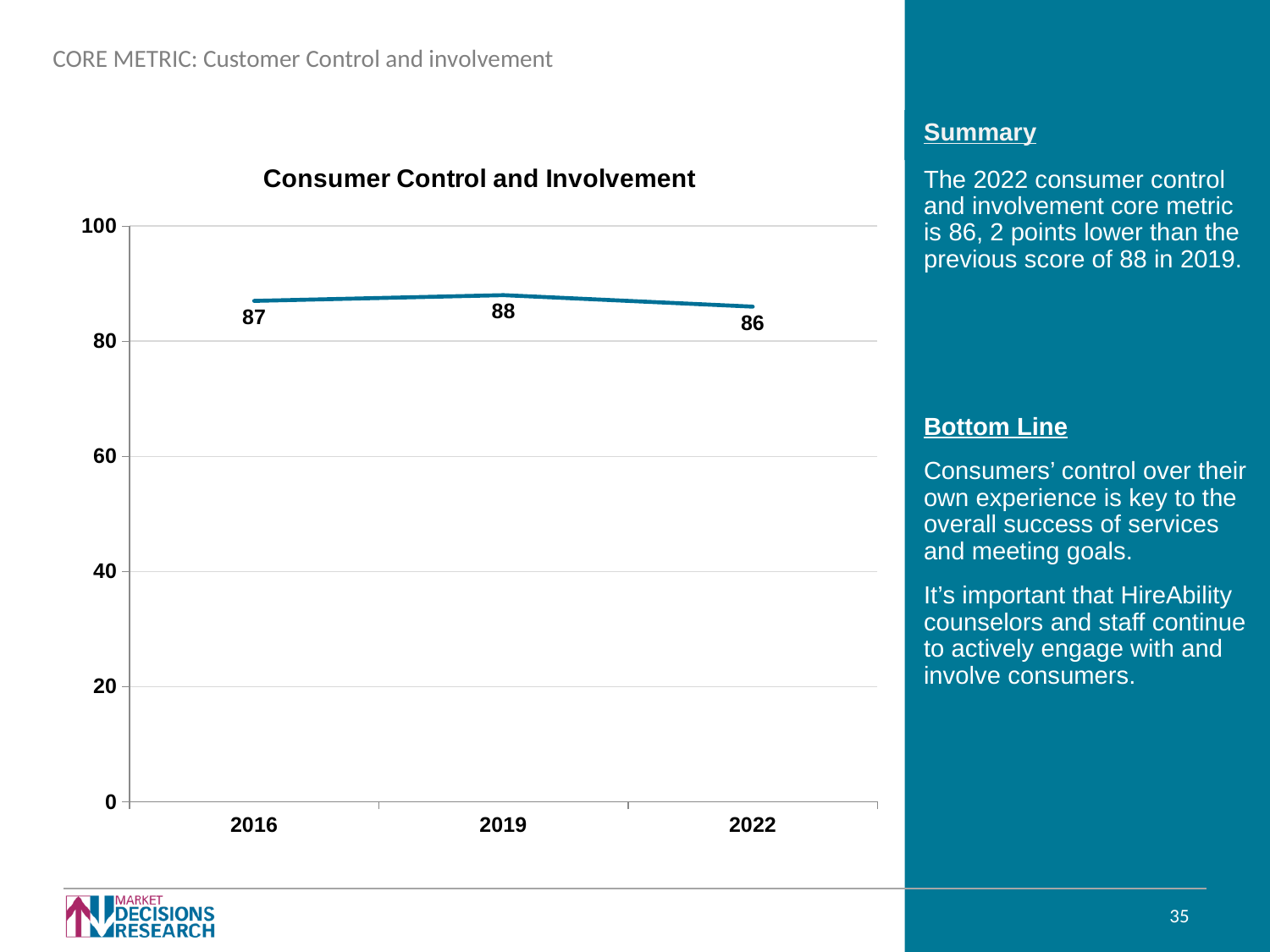
What is the difference between the values for 2019 and 2022? 2 Is the value for 2022 greater or less than 80? greater What kind of chart is shown? line chart Which is larger, the value for 2016 or the value for 2022? 2016 What is the value for 2022? 86 Which year has the lowest value? 2022 Which year has the highest value? 2019 What is the difference between the values for 2016 and 2019? 1 What is the title of the chart? Consumer Control and Involvement What is the value for 2016? 87 How many years are plotted on the chart? 3 What is the value for 2019? 88